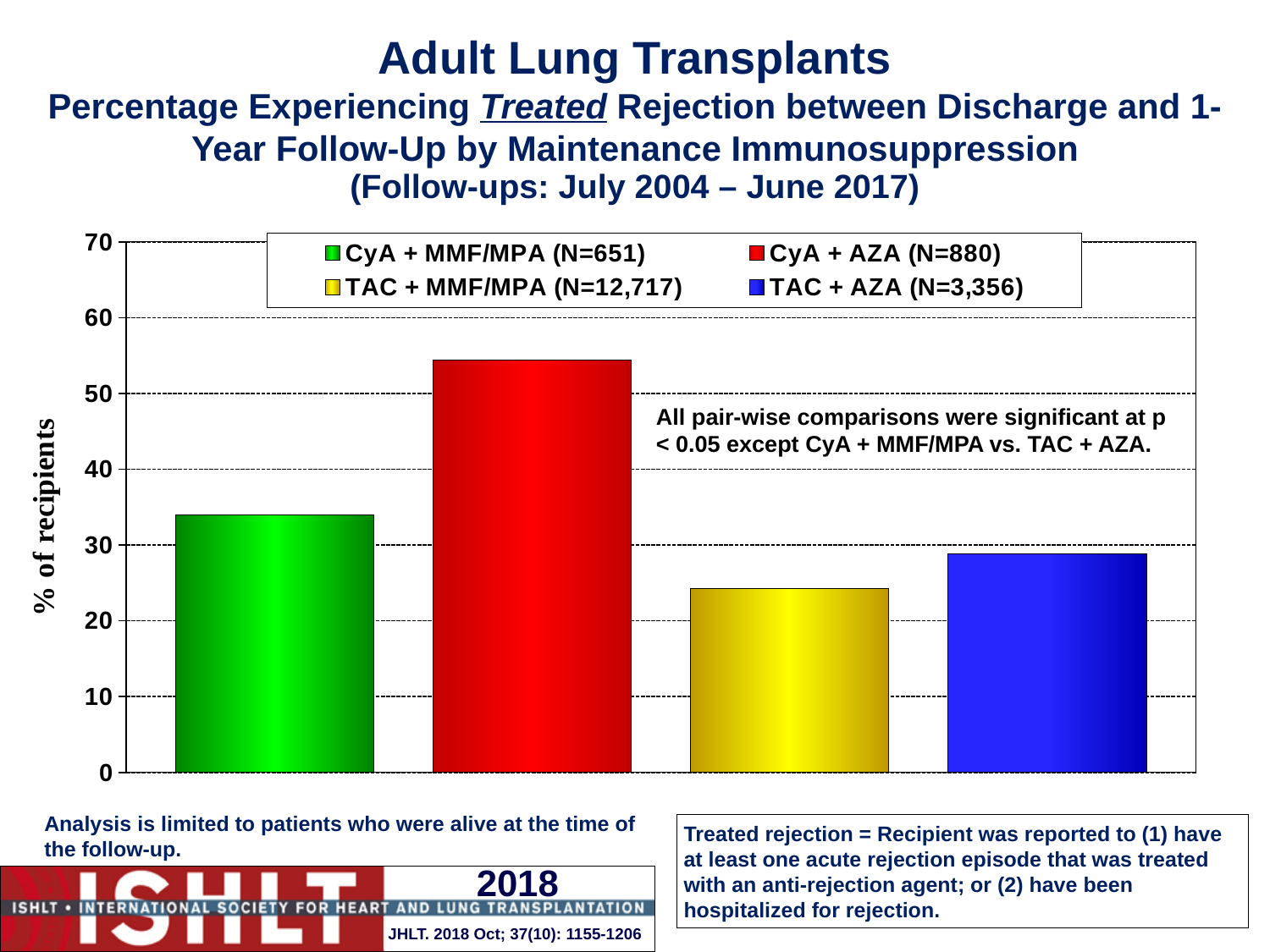
Is the value for TAC + AZA greater or less than 20? greater Which is larger, the value for CyA + MMF/MPA or the value for TAC + AZA? CyA + MMF/MPA According to the legend, what is the N for the TAC + MMF/MPA group? 12,717 Is the value for TAC + MMF/MPA greater or less than 30? less What is the label on the y axis of the chart? % of recipients Is the value for CyA + AZA greater or less than 50? greater What kind of chart is shown on the slide? bar chart Which maintenance immunosuppression group has the lowest percentage of recipients with treated rejection? TAC + MMF/MPA Which maintenance immunosuppression group has the highest percentage of recipients with treated rejection? CyA + AZA How many series does the legend list? 4 How many bars are plotted in the chart? 4